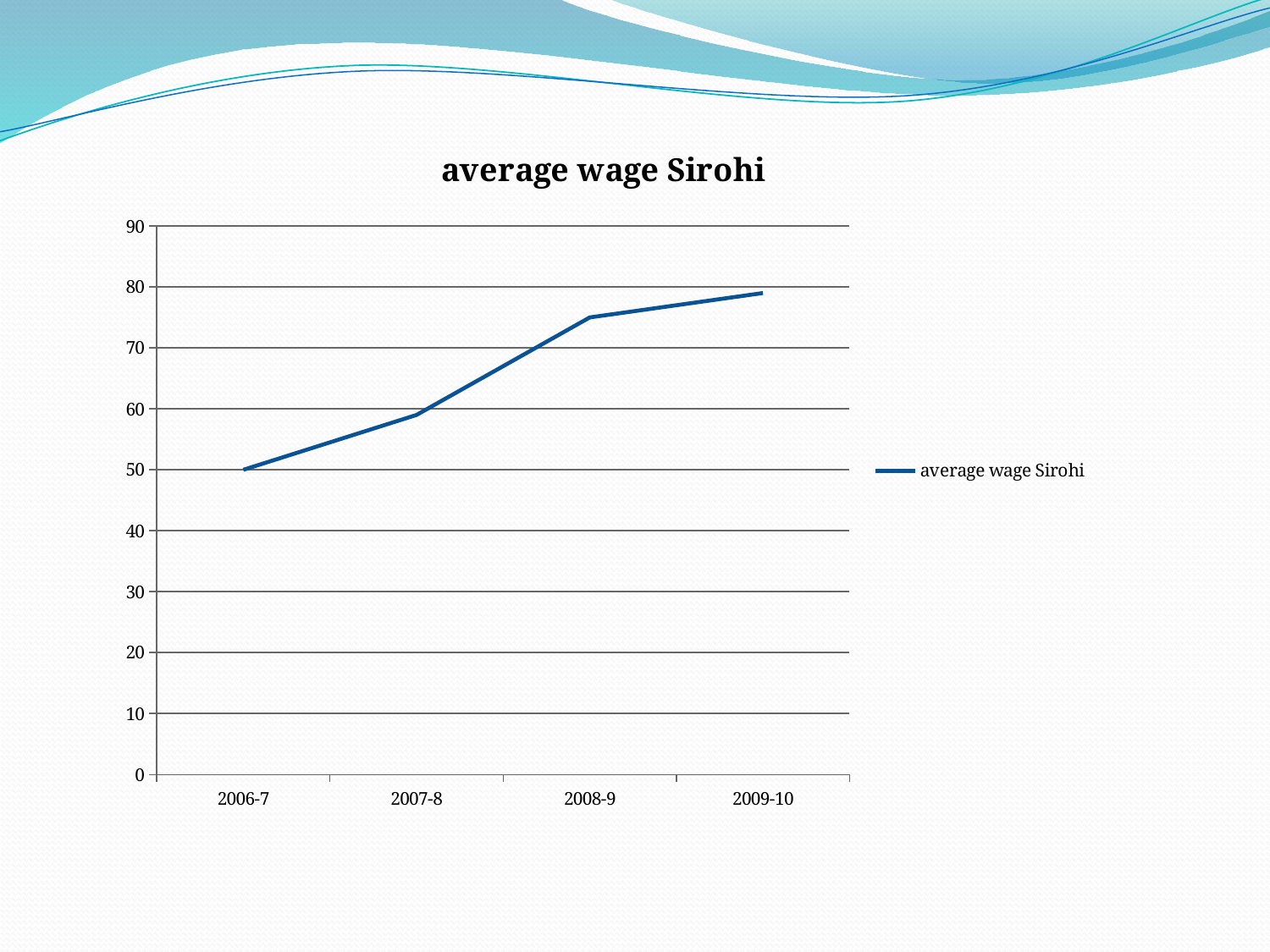
Which year has the lowest average wage? 2006-7 Which year has the highest average wage? 2009-10 What is the title of the chart? average wage Sirohi Do the values rise or fall from 2006-7 to 2009-10? rise What is the value for 2006-7? 50 Is the value for 2008-9 greater or less than 70? greater How many points are plotted along the x axis? 4 How many series does the legend list? 1 Is the value for 2007-8 greater or less than 50? greater What kind of chart is shown on the slide? line chart Which is larger, the value for 2007-8 or the value for 2008-9? 2008-9